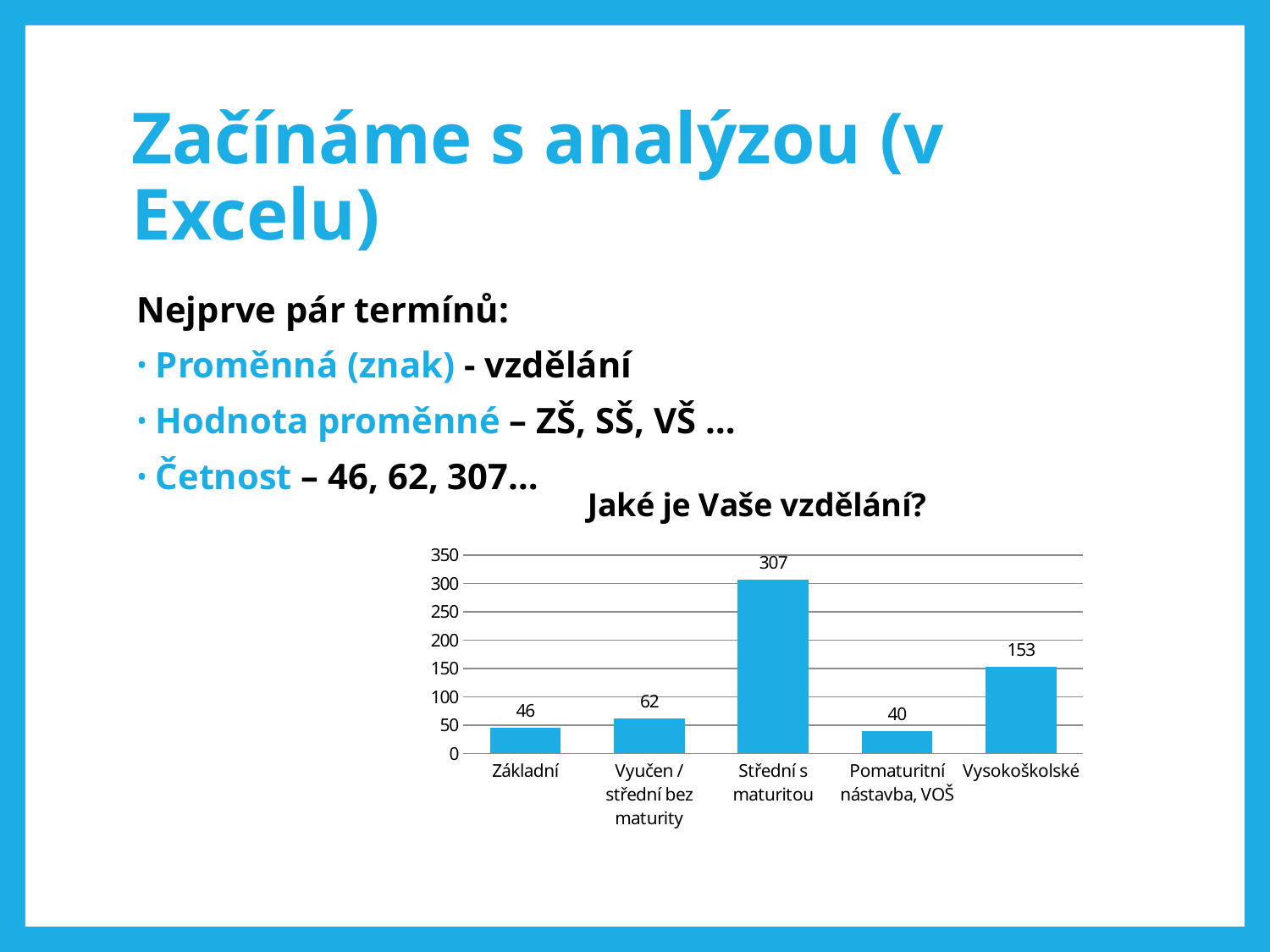
What kind of chart is shown on the slide? bar chart What is the value for Střední s maturitou? 307 What is the value for Vysokoškolské? 153 What is the title of the chart? Jaké je Vaše vzdělání? How many categories are shown on the chart? 5 Which category has the highest value? Střední s maturitou What is the value for Základní? 46 What is the value for Pomaturitní nástavba, VOŠ? 40 Which is larger, the value for Vysokoškolské or the value for Vyučen / střední bez maturity? Vysokoškolské What is the difference between the values for Vyučen / střední bez maturity and Základní? 16 Which category has the lowest value? Pomaturitní nástavba, VOŠ What is the difference between the values for Střední s maturitou and Vysokoškolské? 154